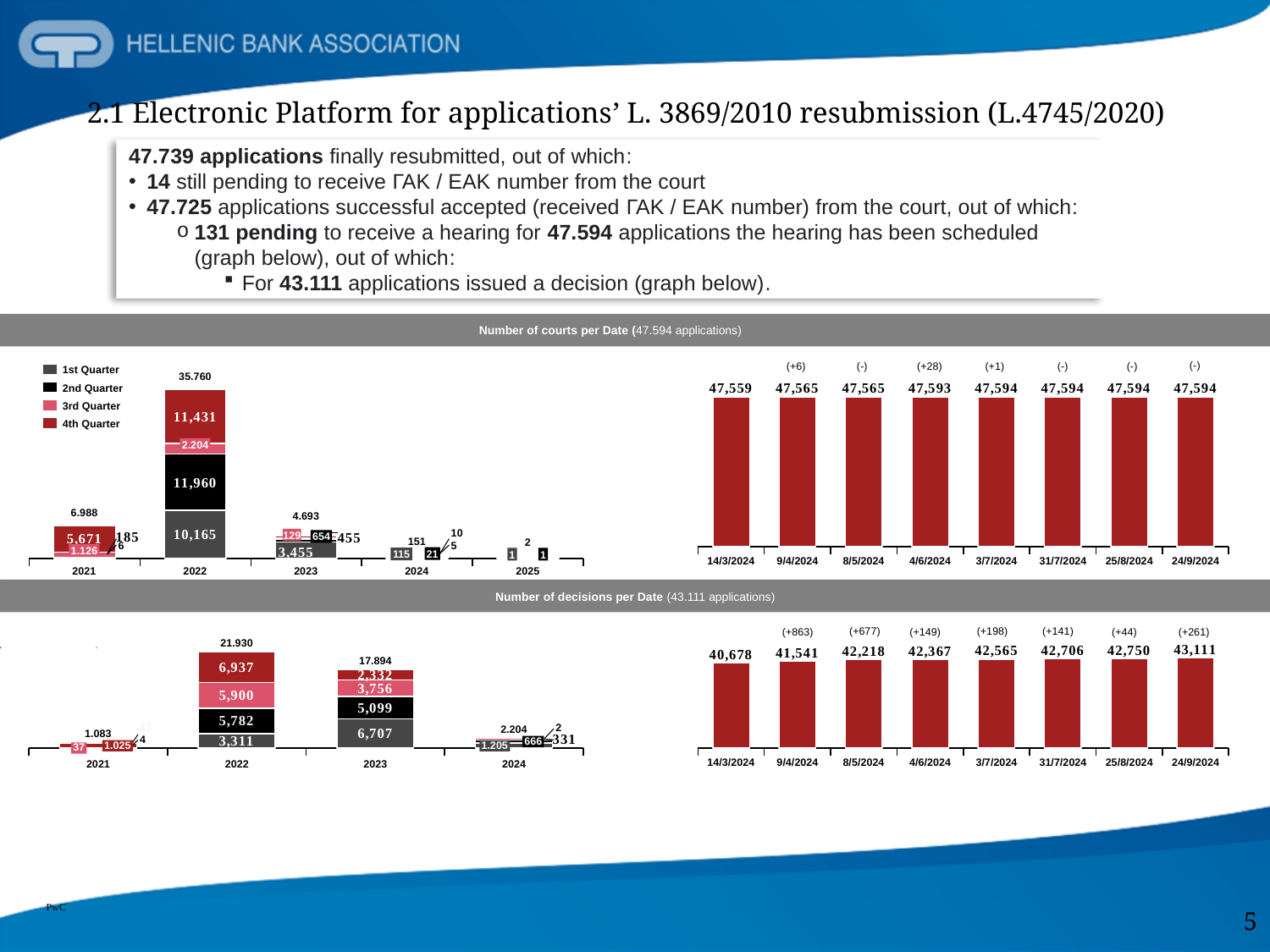
In the 'Number of courts per Date' chart, what is the value for 4/6/2024? 47,593 In the 'Number of decisions per Date' chart, do the values rise or fall from 14/3/2024 to 24/9/2024? rise In the stacked bar chart of decisions per year (bottom left), which year has the highest total? 2022 In the 'Number of decisions per Date' chart, what is the difference between the values for 24/9/2024 and 14/3/2024? 2,433 In the 'Number of decisions per Date' chart, what is the value for 24/9/2024? 43,111 In the 'Number of decisions per Date' chart, what is the value for 9/4/2024? 41,541 In the 'Number of courts per Date' chart, what is the value for 14/3/2024? 47,559 How many series does the legend of the stacked bar chart of courts per year (top left) list? 4 How many dates are shown on the x axis of the 'Number of courts per Date' chart? 8 In the 'Number of decisions per Date' chart, which date has the lowest value? 14/3/2024 In the stacked bar chart of courts per year (top left), what is the 4th Quarter value for 2022? 11,431 In the stacked bar chart of courts per year (top left), what is the total shown above the 2022 bar? 35.760